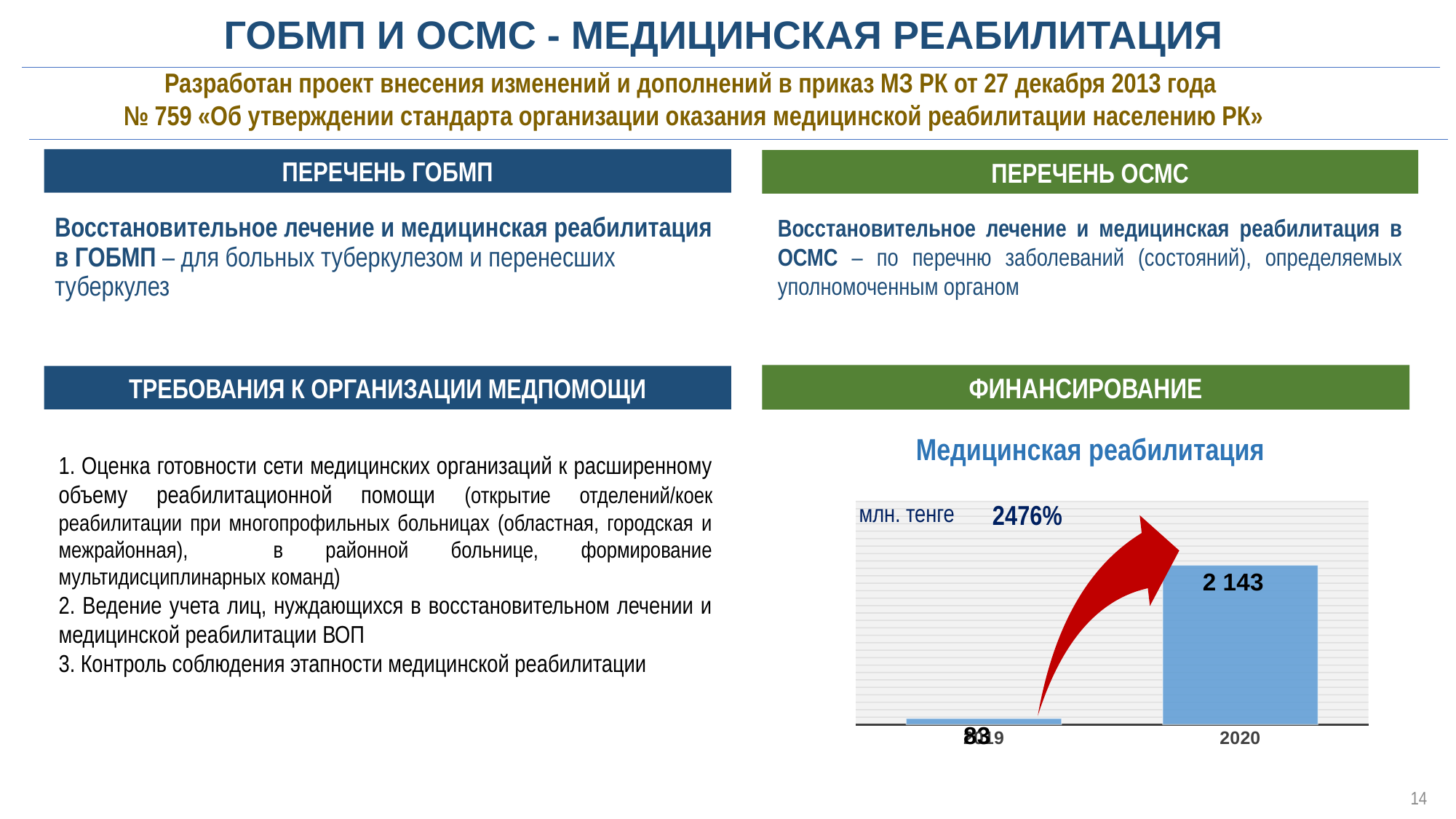
What kind of chart is the Медицинская реабилитация chart? Bar chart What percentage is printed above the bars in the Медицинская реабилитация chart? 2476% In the Медицинская реабилитация chart, which is larger: the value for 2019 or the value for 2020? 2020 Do the values in the Медицинская реабилитация chart rise or fall from 2019 to 2020? Rise Which year has the lowest value in the Медицинская реабилитация chart? 2019 Which year has the highest value in the Медицинская реабилитация chart? 2020 What is the title of the chart in the ФИНАНСИРОВАНИЕ section? Медицинская реабилитация How many years (categories) are shown in the Медицинская реабилитация chart? 2 What is the value for 2020 in the Медицинская реабилитация chart? 2 143